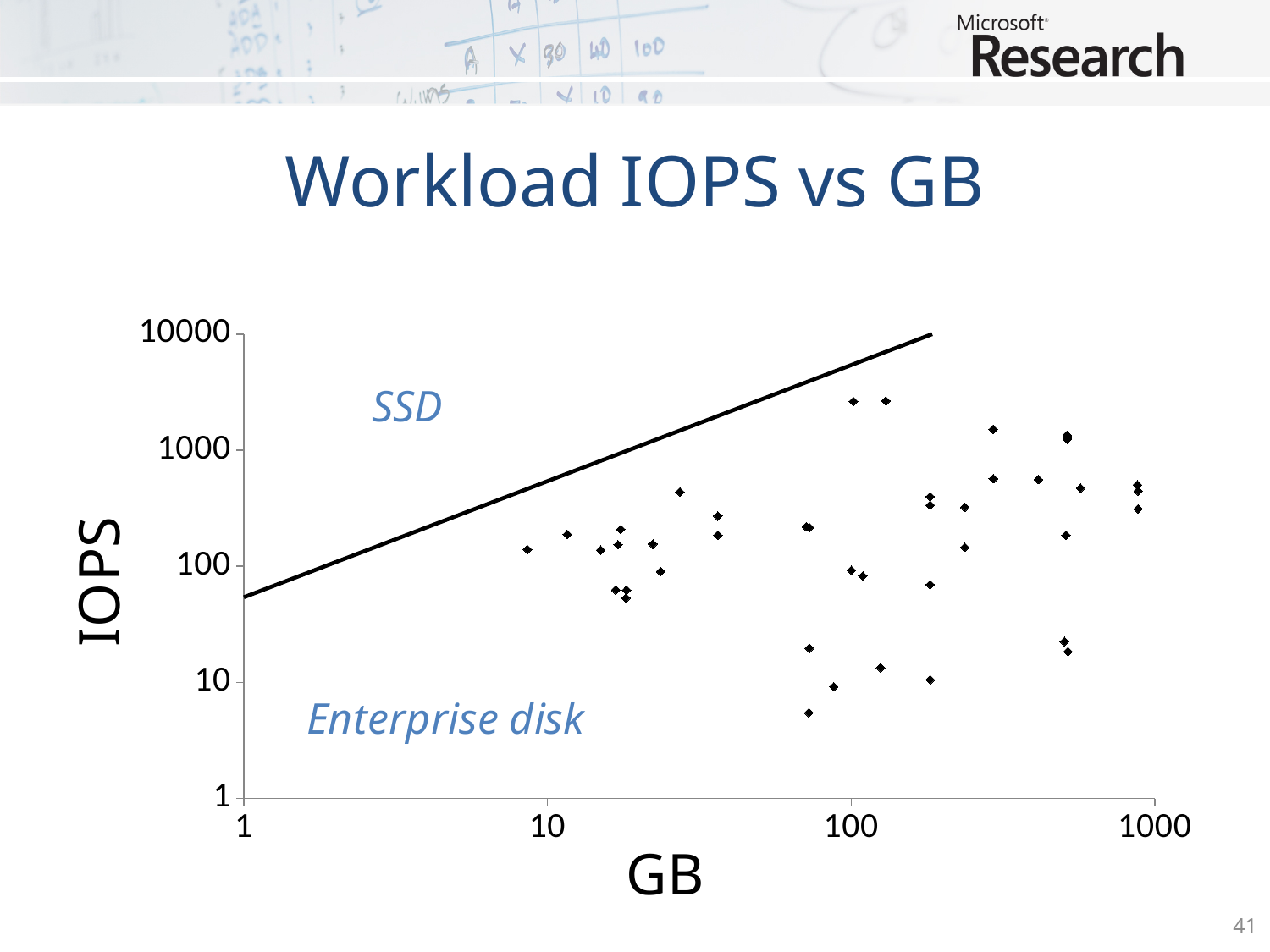
How many tick labels are shown on the x axis? 4 Is the highest plotted IOPS value greater or less than 10000? less Is the lowest plotted IOPS value greater or less than 10? less Which region label appears above the diagonal line and which below it? SSD above, Enterprise disk below Is the largest plotted GB value greater or less than 1000? less Do any of the plotted points lie above the diagonal line, in the SSD region? No Does the diagonal line rise or fall as GB increases along the x axis? rises What is the title of the chart? Workload IOPS vs GB What kind of chart is shown on the slide? scatter plot What is the highest tick value shown on the IOPS axis? 10000